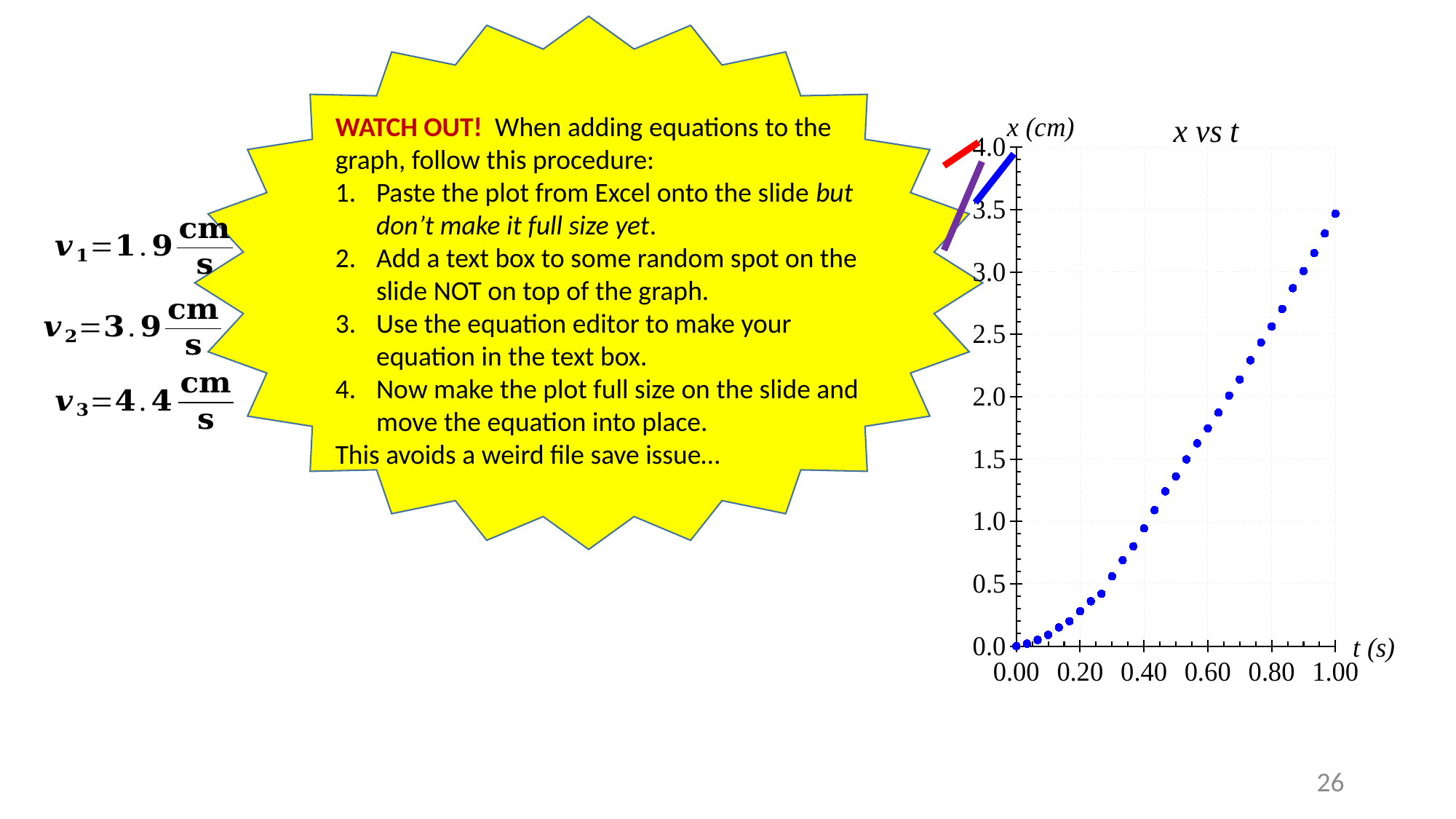
In the "x vs t" chart, is the value of x at t = 0.50 greater or less than 1.5? less In the "x vs t" chart, is the value of x at t = 1.00 greater or less than 3.0? greater In the "x vs t" chart, what is the value of x at t = 0.00? 0.0 In the "x vs t" chart, at which value of t is x highest? 1.00 In the "x vs t" chart, is the value of x at t = 0.80 greater or less than 2.0? greater What is the label of the horizontal axis of the "x vs t" chart? t (s) What is the title of the chart on the right of the slide? x vs t In the "x vs t" chart, which is larger: the value of x at t = 0.80 or at t = 0.40? t = 0.80 In the "x vs t" chart, at which value of t is x lowest? 0.00 In the "x vs t" chart, do the plotted values rise or fall as t increases? rise What kind of chart is the "x vs t" chart? scatter chart